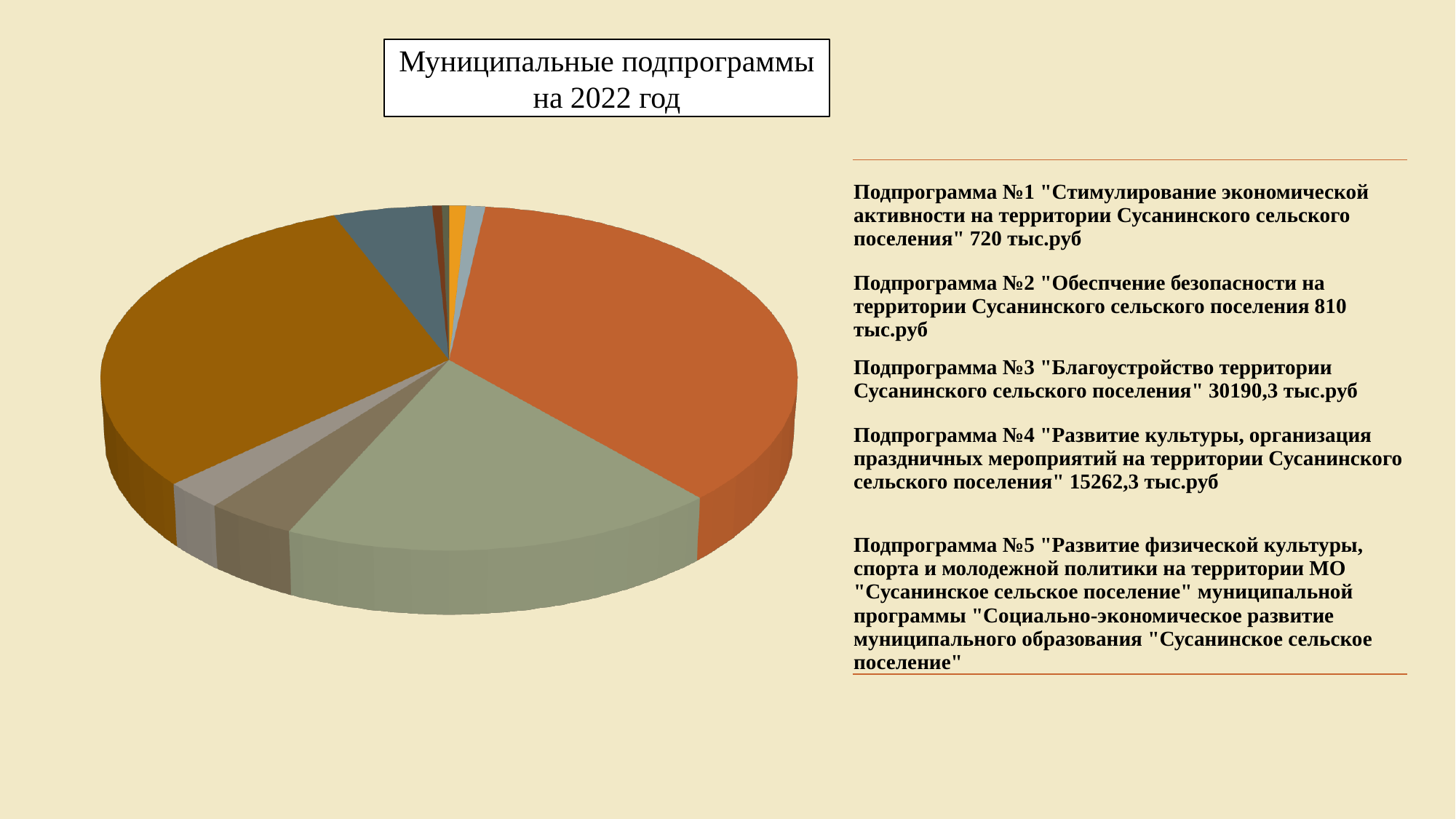
Does the pie chart display a legend or data labels for its slices? No What is the title shown above the chart on the slide? Муниципальные подпрограммы на 2022 год What kind of chart is shown on the slide? pie chart How many slices does the pie chart have? 10 Which is larger in the pie chart: the orange slice on the right or the small light grey slice at the top? the orange slice on the right